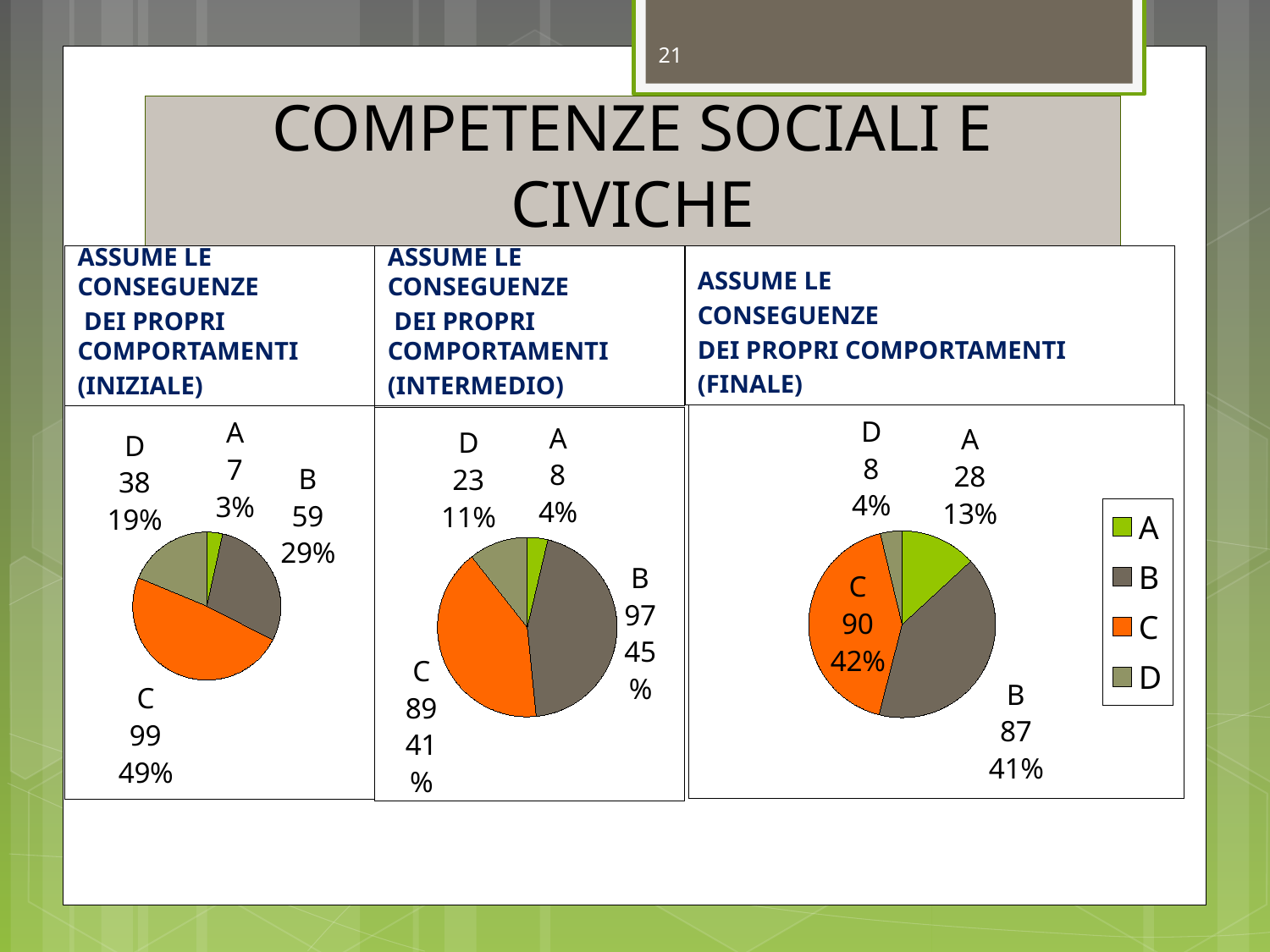
In the INIZIALE pie chart, which category has the largest slice? C In the FINALE pie chart, what percentage share does category C have? 42% In the INTERMEDIO pie chart, what is the value for category B? 97 In the FINALE pie chart, what is the value for category A? 28 How many categories does the legend on the slide list? 4 In the INTERMEDIO pie chart, what percentage share does category A have? 4% In the INIZIALE pie chart, which is larger, the value for B or the value for D? B What type of chart is used for the FINALE data? Pie chart In the INIZIALE pie chart, what percentage share does category D have? 19% In the FINALE pie chart, which category has the smallest slice? D In the INTERMEDIO pie chart, what is the difference between the values for B and C? 8 In the INIZIALE pie chart, what is the value for category C? 99